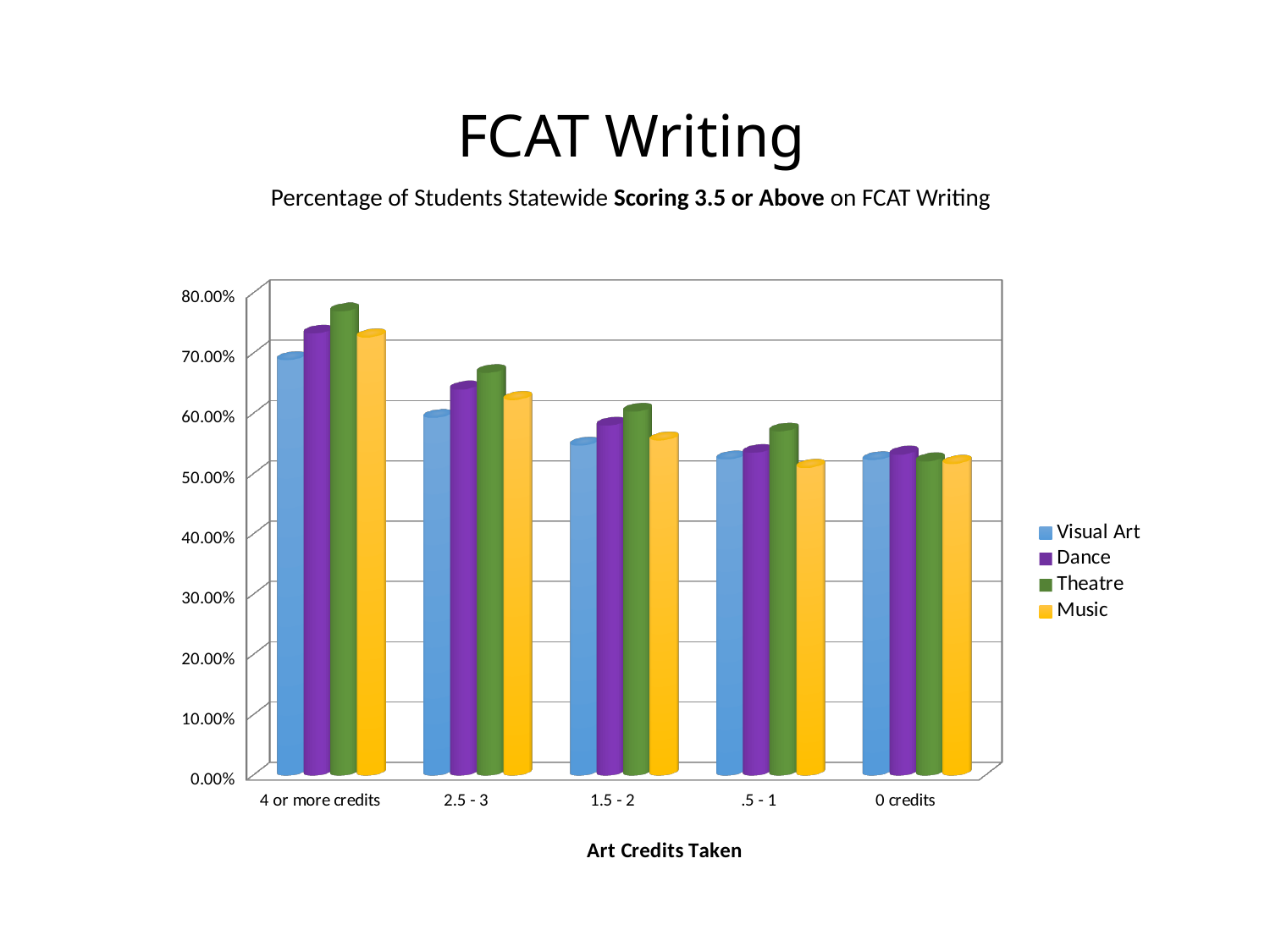
Which series has the highest value for the '4 or more credits' category? Theatre Is the Theatre value for '2.5 - 3' credits greater or less than 60.00%? greater In which category is the Theatre value lowest? 0 credits What is the title of the x axis? Art Credits Taken Is the Theatre value for '4 or more credits' greater or less than 70.00%? greater Do the Theatre values rise or fall moving from '4 or more credits' to '0 credits' along the x axis? fall For the '1.5 - 2' credits category, which is larger: Theatre or Visual Art? Theatre What kind of chart is shown on the slide? bar chart How many categories of art credits are shown on the x axis? 5 Is the Dance value for '4 or more credits' greater or less than 70.00%? greater How many series does the legend list? 4